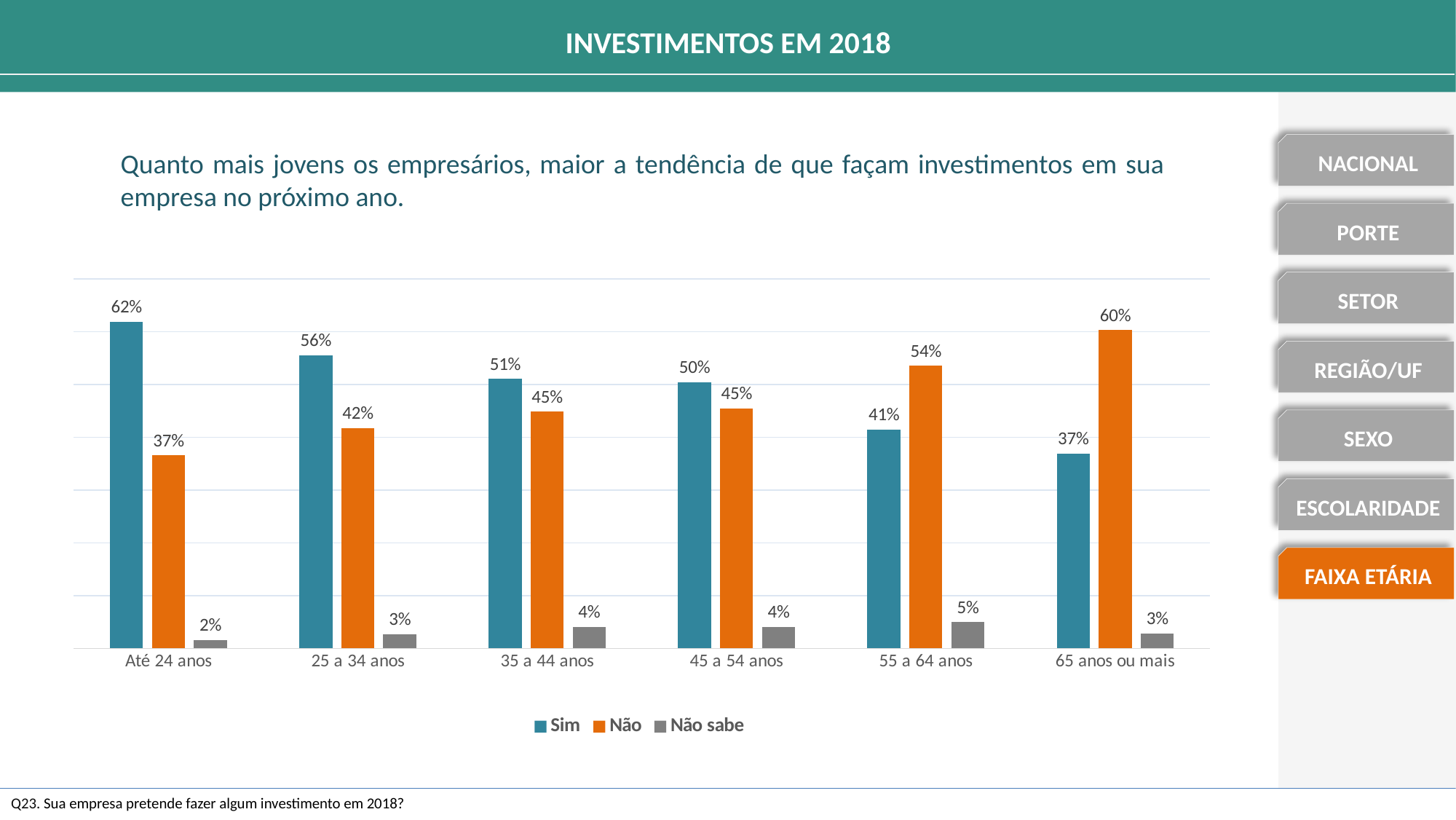
What is the difference between the "Sim" and "Não" values for the "25 a 34 anos" age group? 14% Do the "Sim" values rise or fall as the age groups get older along the x axis? Fall What is the value of "Sim" for the "Até 24 anos" age group? 62% For the "55 a 64 anos" age group, which is larger: "Sim" or "Não"? Não What colour represents the "Não" series in the chart? Orange Which age group has the lowest "Não" value? Até 24 anos What kind of chart is shown on the slide? Bar chart How many series does the legend list? 3 How many age groups are shown on the x axis? 6 Which age group has the highest "Sim" value? Até 24 anos What is the value of "Não" for the "65 anos ou mais" age group? 60% What is the value of "Não sabe" for the "55 a 64 anos" age group? 5%